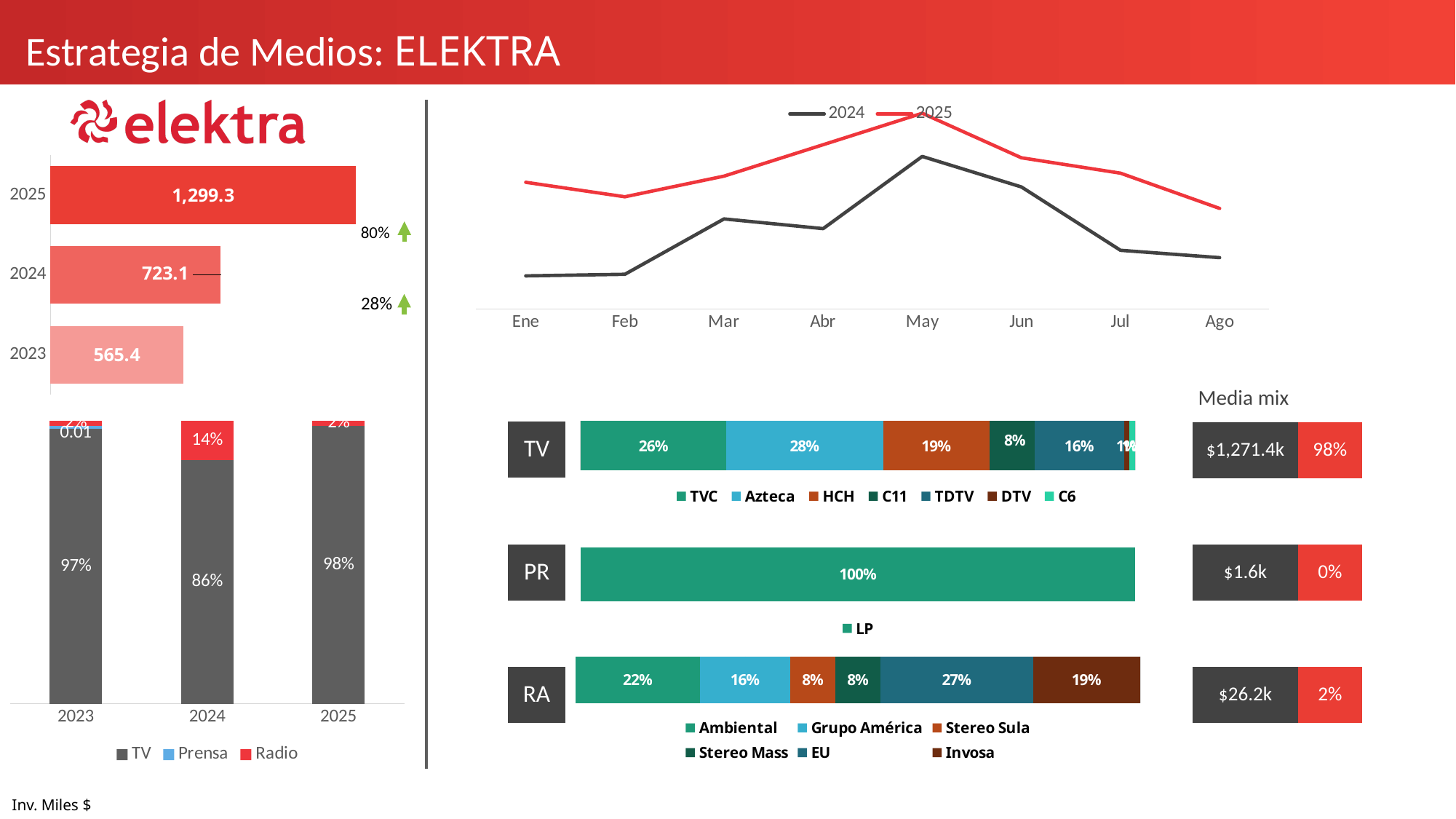
In the RA stacked bar on the right, which station has the largest share? EU In the horizontal bar chart of yearly investment on the left, what is the difference between the 2025 and 2024 values? 576.2 In the line chart at the top right, is the 2025 line above or below the 2024 line in Ene? above In the horizontal bar chart of yearly investment on the left, what is the value for 2023? 565.4 In the stacked bar chart of TV, Prensa and Radio by year at the bottom left, what is the TV share for 2024? 86% In the TV stacked bar on the right, what is the share for Azteca? 28% In the horizontal bar chart of yearly investment on the left, which year has the lowest value? 2023 In the line chart at the top right, how many months are shown on the x axis? 8 In the stacked bar chart of TV, Prensa and Radio by year at the bottom left, how many series does the legend list? 3 In the horizontal bar chart of yearly investment on the left, what is the value for 2025? 1,299.3 In the line chart at the top right, in which month does the 2025 line reach its highest point? May In the Media mix table on the right, what is the amount shown for RA? $26.2k